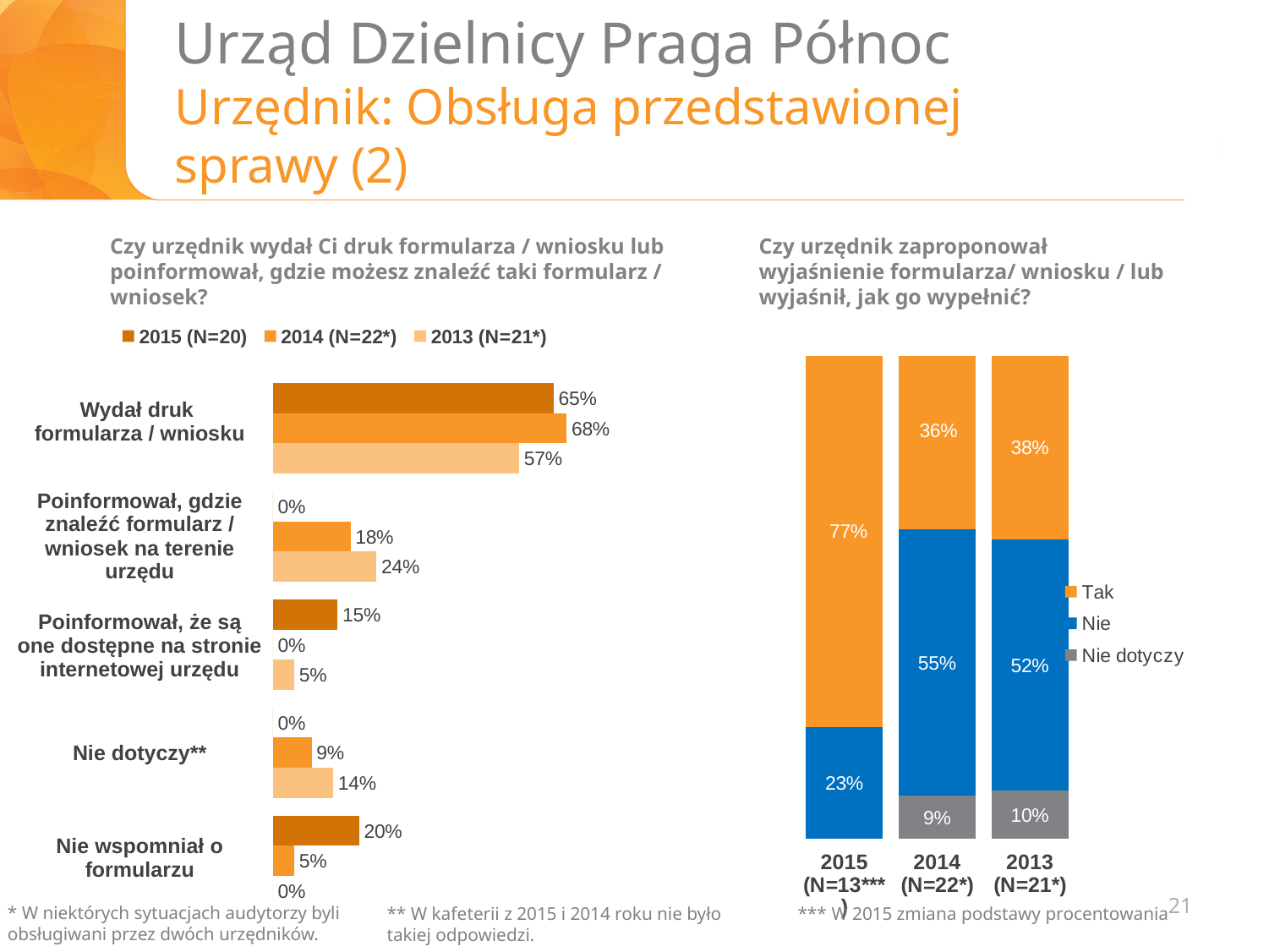
In the right chart, is the "Tak" share for 2014 larger or smaller than for 2013? Smaller In the left chart, which category has the highest 2015 (N=20) value? Wydał druk formularza / wniosku What kind of chart is the left chart? Bar chart In the left chart, what is the 2014 (N=22*) value for "Wydał druk formularza / wniosku"? 68% In the left chart, how many series does the legend list? 3 In the left chart, what is the 2013 (N=21*) value for "Poinformował, gdzie znaleźć formularz / wniosek na terenie urzędu"? 24% In the left chart, what is the difference between the 2014 and 2013 values for "Wydał druk formularza / wniosku"? 11% In the left chart, how many categories are shown? 5 In the left chart, what is the 2015 (N=20) value for "Nie wspomniał o formularzu"? 20% In the right chart, which year has the highest "Nie" share? 2014 (N=22*) In the right chart, what is the "Nie dotyczy" share for 2013 (N=21*)? 10% In the right chart, what is the "Tak" share for 2015 (N=13***)? 77%